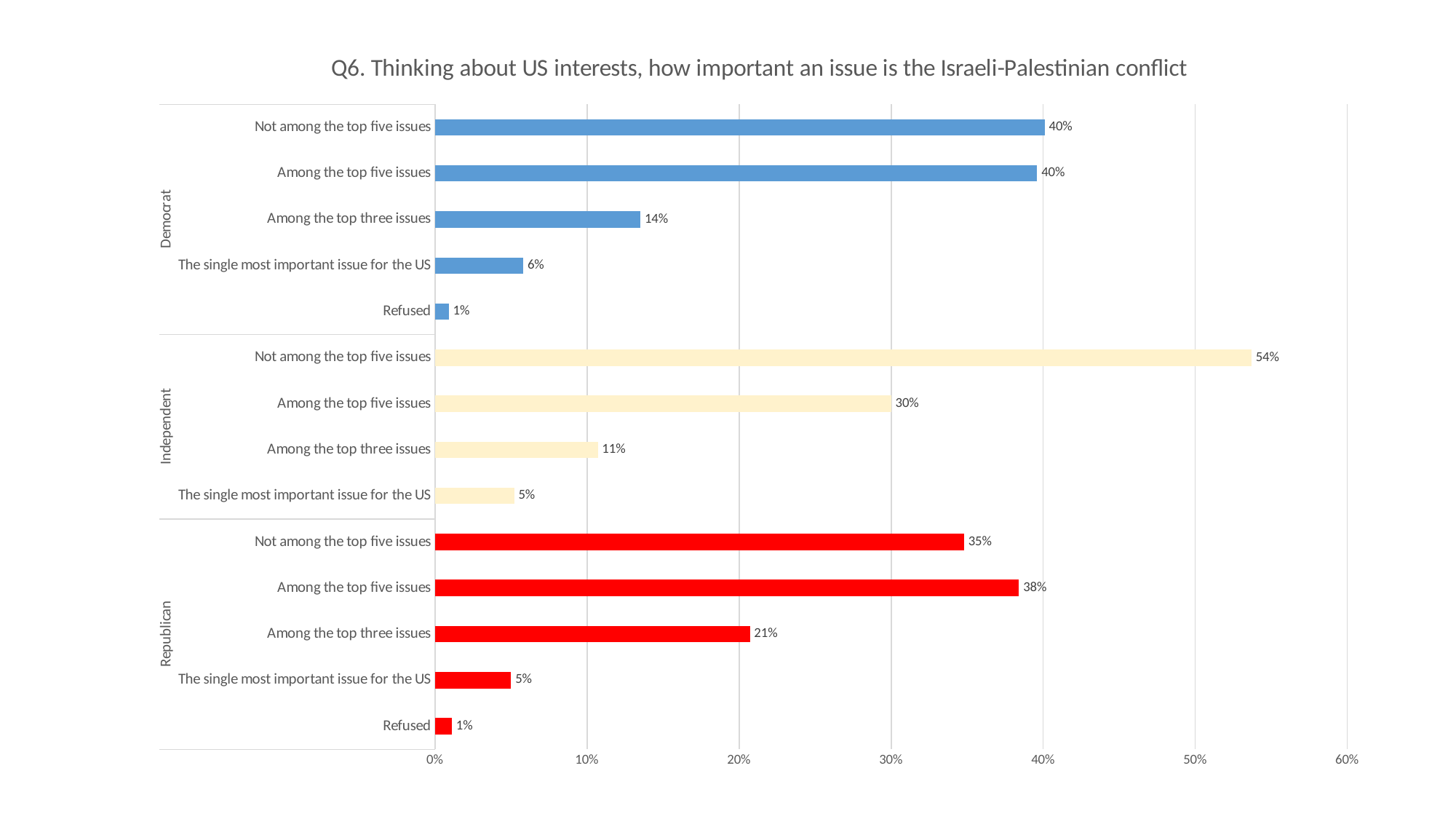
What percentage of Republicans said the conflict is among the top five issues? 38% What colour are the bars for the Republican group? Red Is the Independent value for 'Among the top five issues' greater or less than 20%? greater What is the difference between the Independent and Republican values for 'Not among the top five issues'? 19% What percentage of Democrats said the Israeli-Palestinian conflict is among the top three issues? 14% Within the Republican group, which response has the lowest value? Refused Which bar on the chart has the highest value? Independent, Not among the top five issues How many bars are plotted for the Independent group? 4 What type of chart is shown on the slide? Bar chart Which is larger: the Democrat value for 'Among the top three issues' or the Republican value for 'Among the top three issues'? Republican What percentage of Independents said the conflict is not among the top five issues? 54% What percentage of Republicans said the conflict is the single most important issue for the US? 5%